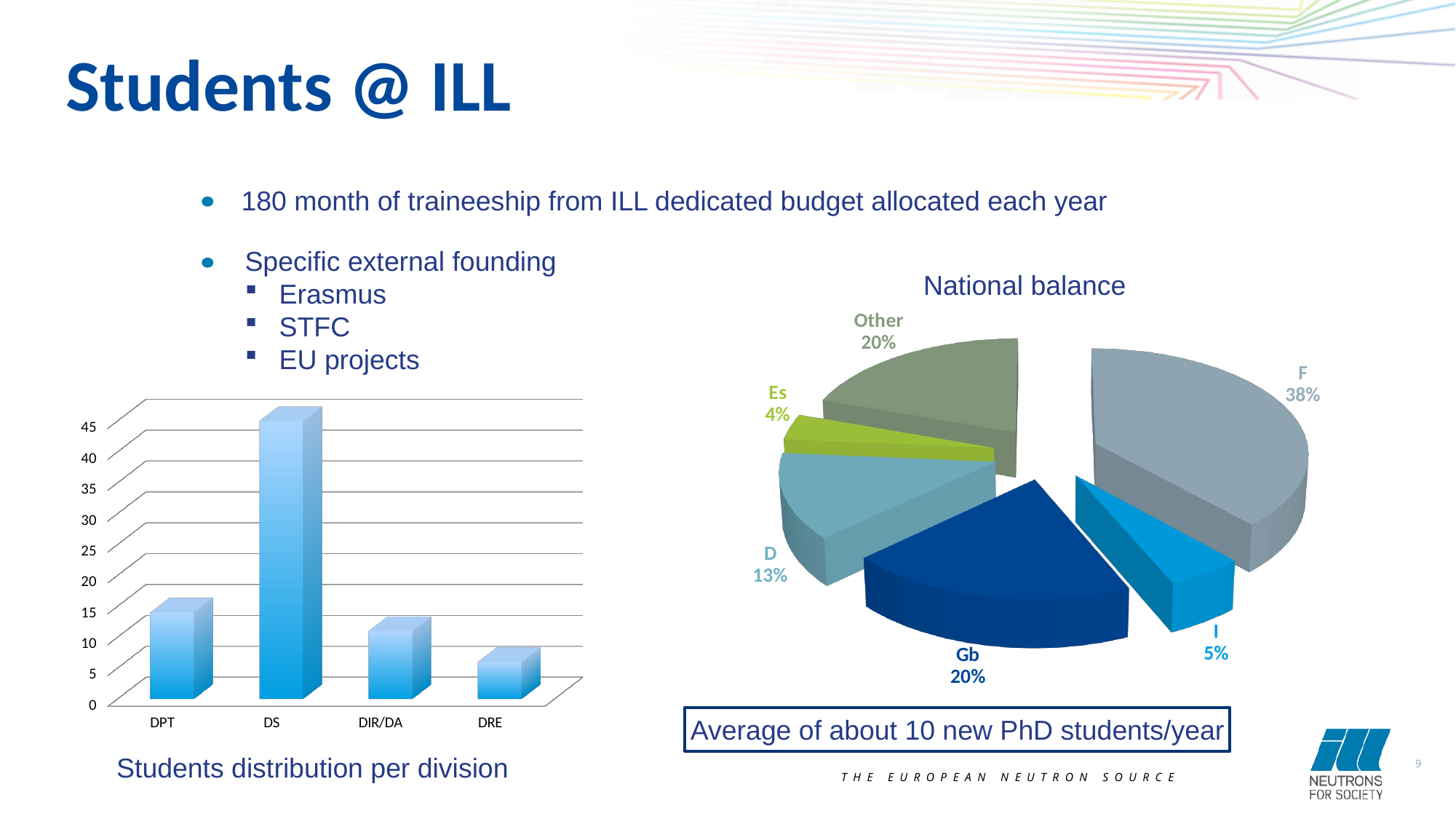
In the 'Students distribution per division' chart, is the value for DS greater or less than 40? greater What type of chart is the 'Students distribution per division' chart? bar chart In the 'National balance' pie chart, what share does F have? 38% How many slices does the 'National balance' pie chart have? 6 In the 'Students distribution per division' chart, is the value for DRE greater or less than 10? less In the 'National balance' pie chart, what is the difference between the shares of F and Gb? 18% In the 'Students distribution per division' chart, which division has the highest bar? DS In the 'National balance' pie chart, which category has the smallest share? Es In the 'Students distribution per division' chart, which division has the lowest bar? DRE How many divisions are shown in the 'Students distribution per division' chart? 4 In the 'Students distribution per division' chart, is the value for DPT greater or less than 10? greater In the 'National balance' pie chart, what share does D have? 13%